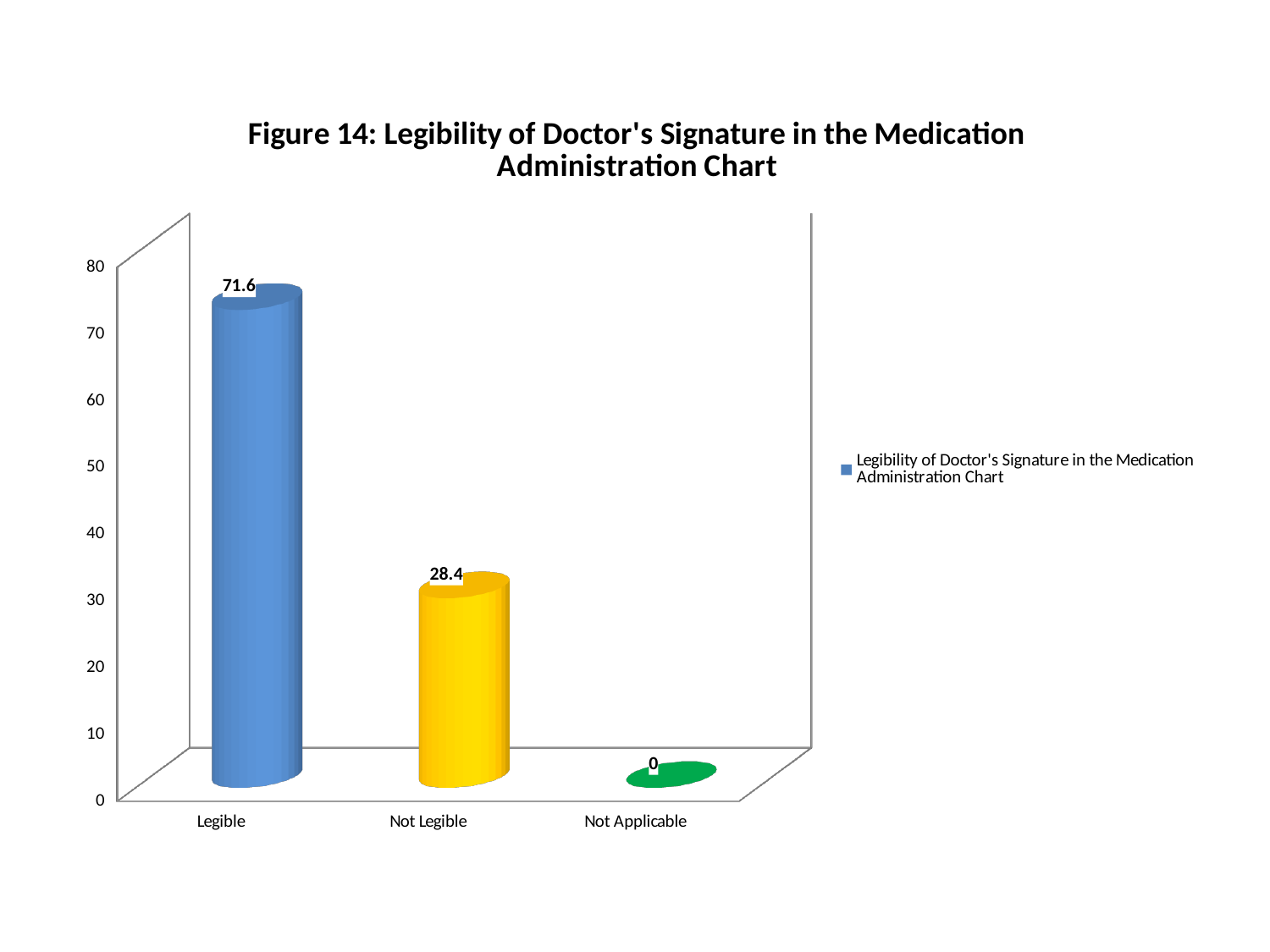
What is the value for Not Applicable? 0 What is the value for Not Legible? 28.4 What kind of chart is shown on the slide? Bar chart What is the title of the chart? Figure 14: Legibility of Doctor's Signature in the Medication Administration Chart Is the value for Not Legible greater or less than 30? less How many series does the legend list? 1 How many categories are shown on the x axis? 3 Which category has the highest value? Legible Which is larger, the value for Legible or the value for Not Legible? Legible What is the difference between the values for Legible and Not Legible? 43.2 Which category has the lowest value? Not Applicable What is the value for Legible? 71.6